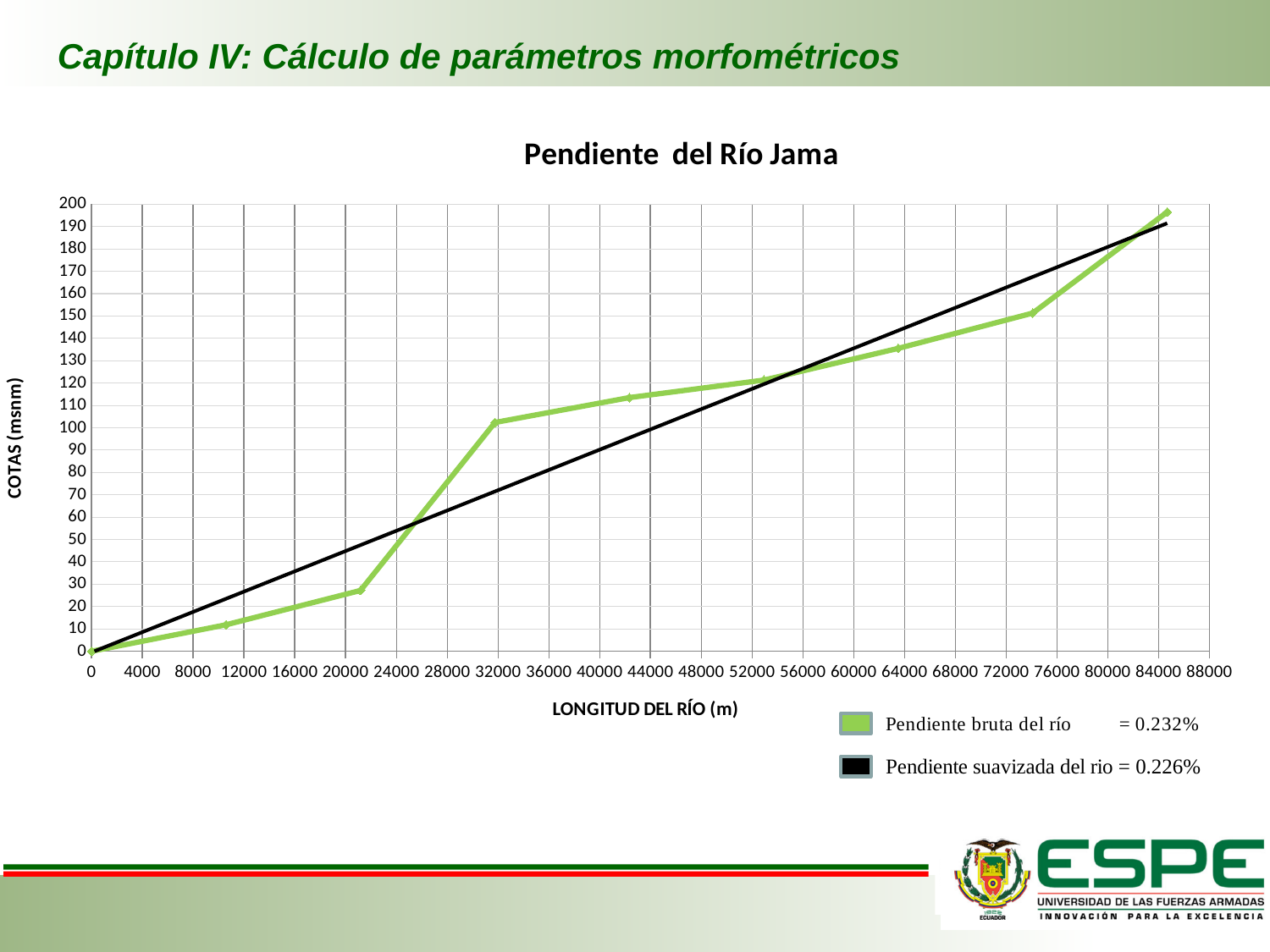
Do the values of the 'Pendiente bruta del río' line rise or fall as the river length increases? rise What slope value is given for 'Pendiente bruta del río'? 0.232% Is the value of the 'Pendiente bruta del río' line at 32000 m greater or less than 90? greater What is the title of the chart? Pendiente del Río Jama Is the value of the 'Pendiente bruta del río' line at 84000 m greater or less than 180? greater What is the label of the vertical axis? COTAS (msnm) What kind of chart is shown on the slide? line chart Which series has the larger slope value, 'Pendiente bruta del río' or 'Pendiente suavizada del rio'? Pendiente bruta del río What slope value is given for 'Pendiente suavizada del rio'? 0.226% At 32000 m, which line is higher, 'Pendiente bruta del río' or 'Pendiente suavizada del rio'? Pendiente bruta del río Is the value of the 'Pendiente bruta del río' line at 20000 m greater or less than 40? less How many series does the legend list? 2